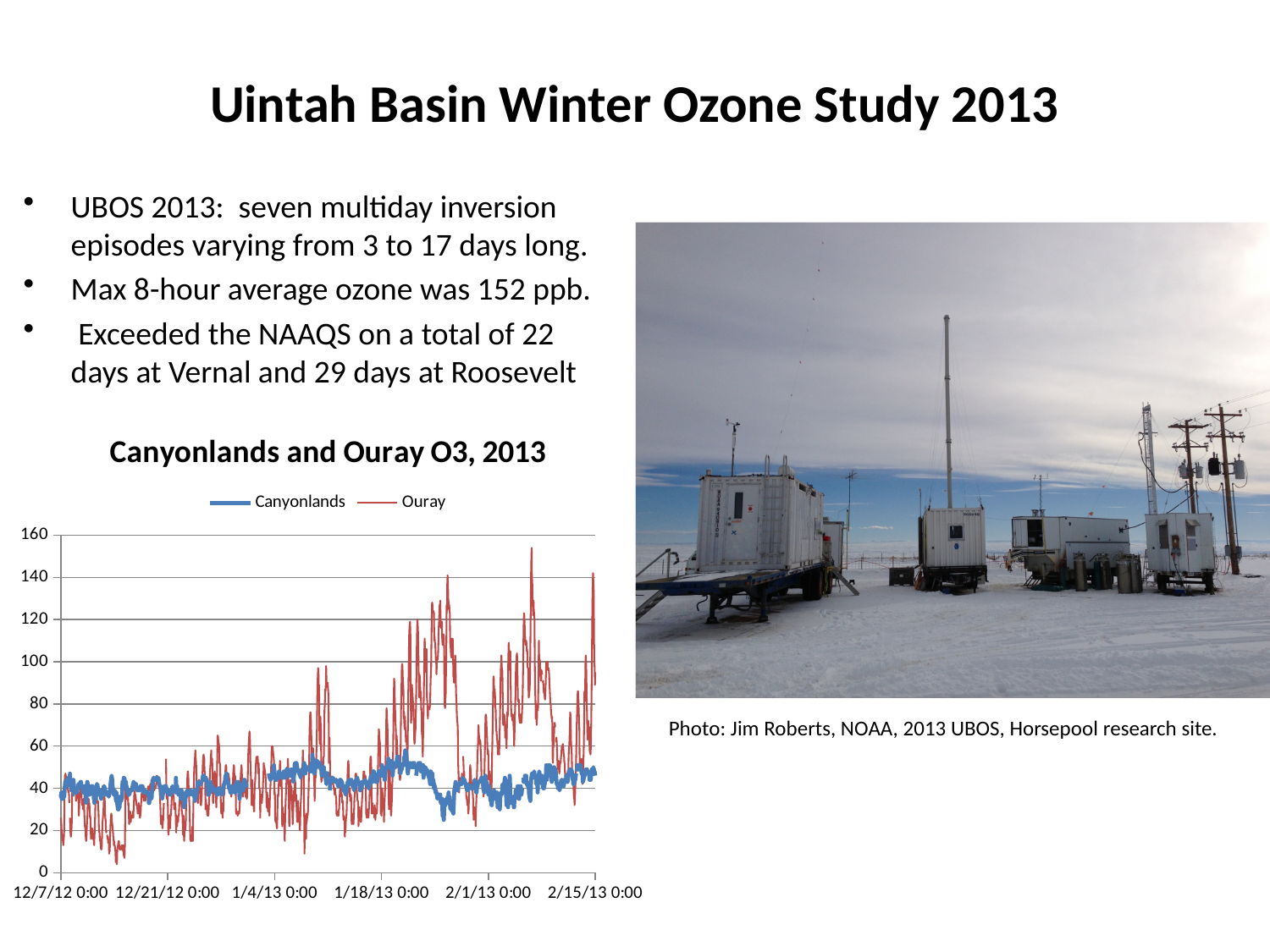
Is the highest value reached by the Canyonlands series greater or less than 80? less Is the Ouray value at the start of the chart (around 12/7/12) greater or less than 100? less What is the highest value shown on the chart's vertical axis? 160 What kind of chart is shown on the slide? line chart Which series stays closer to 40 throughout the chart, Canyonlands or Ouray? Canyonlands Does the Ouray series generally rise or fall between 1/18/13 and 2/15/13 compared with December? rise Which series reaches higher values on the chart, Canyonlands or Ouray? Ouray Which series is drawn in red on the chart? Ouray How many date labels are shown along the chart's x axis? 6 Is the highest value reached by the Ouray series greater or less than 140? greater How many series does the chart legend list? 2 What is the title of the chart? Canyonlands and Ouray O3, 2013